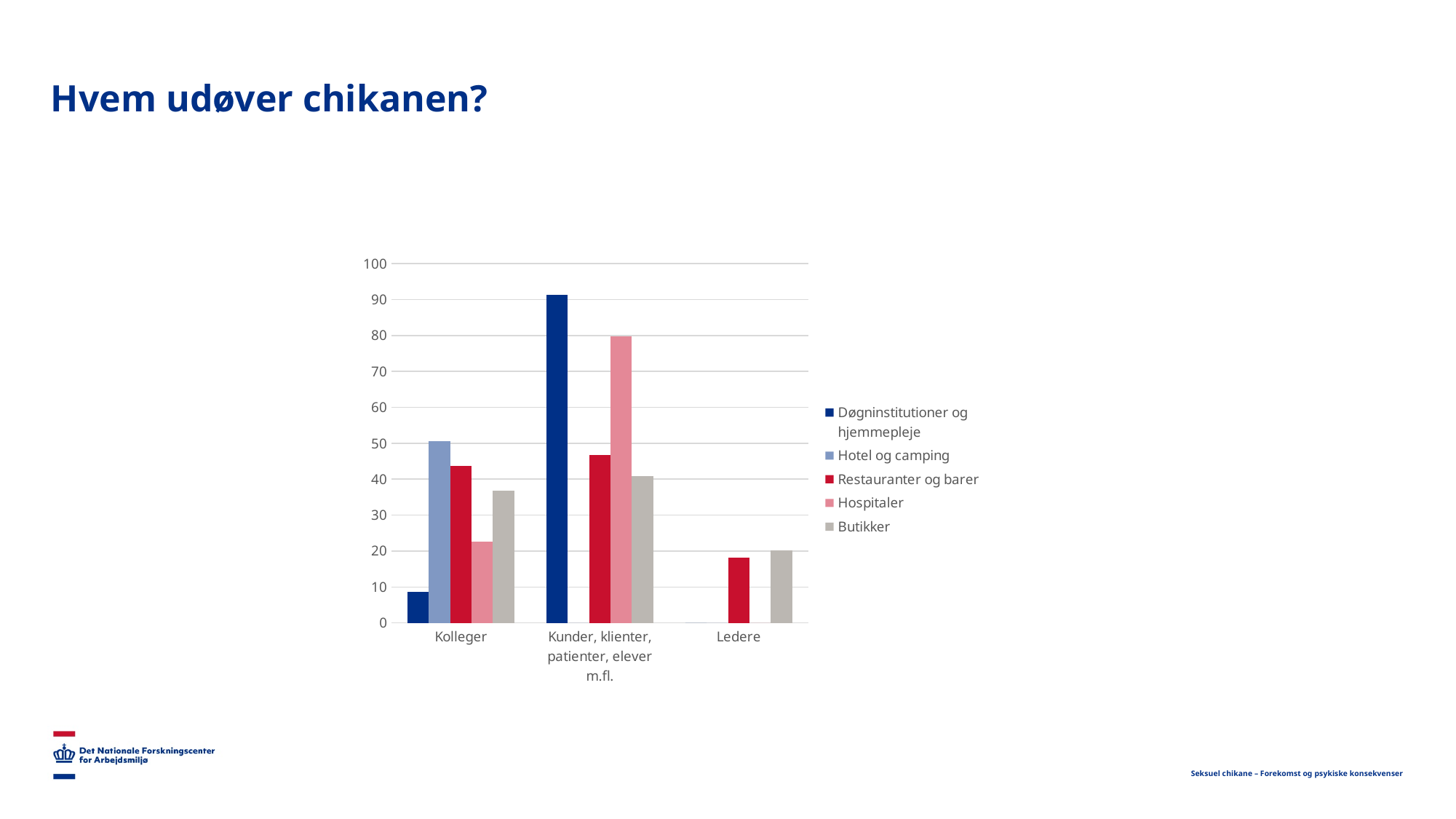
How many series does the legend list? 5 For Kolleger, which is larger: Restauranter og barer or Butikker? Restauranter og barer How many categories are shown on the x axis? 3 What is the title of the slide? Hvem udøver chikanen? Which series has the highest value for Kolleger? Hotel og camping Which series has the lowest value for Kolleger? Døgninstitutioner og hjemmepleje Is the value for Døgninstitutioner og hjemmepleje in the Kunder, klienter, patienter, elever m.fl. category greater or less than 80? greater Is the value for Hospitaler in the Kolleger category greater or less than 30? less Which series has the highest value for Kunder, klienter, patienter, elever m.fl.? Døgninstitutioner og hjemmepleje Is the value for Hotel og camping in the Kolleger category greater or less than 40? greater For Kunder, klienter, patienter, elever m.fl., which is larger: Hospitaler or Restauranter og barer? Hospitaler What kind of chart is shown on the slide? bar chart